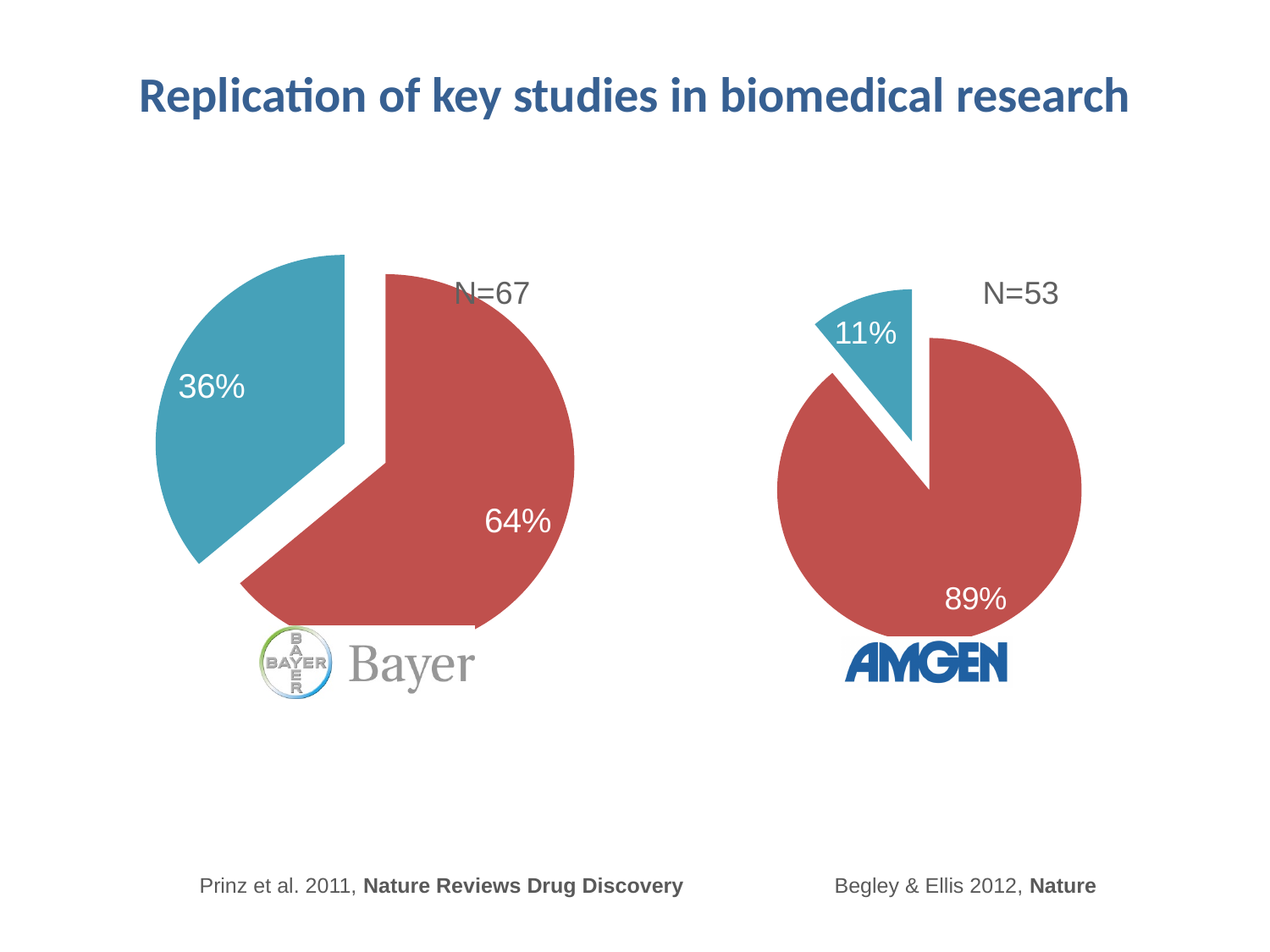
In the left pie chart (Bayer), which slice is larger, the red one or the blue one? red In the right pie chart (Amgen), what share does the red slice represent? 89% In the right pie chart (Amgen), which slice is the smallest? the blue slice (11%) In the left pie chart (Bayer), what share does the red slice represent? 64% What sample size (N) is shown next to the right pie chart (Amgen)? N=53 What is the difference between the red and blue slices in the right pie chart (Amgen)? 78% What kind of chart is shown on the left side of the slide (Bayer)? pie chart How many slices does the right pie chart (Amgen) have? 2 What sample size (N) is shown next to the left pie chart (Bayer)? N=67 In the left pie chart (Bayer), what share does the blue slice represent? 36% How many slices does the left pie chart (Bayer) have? 2